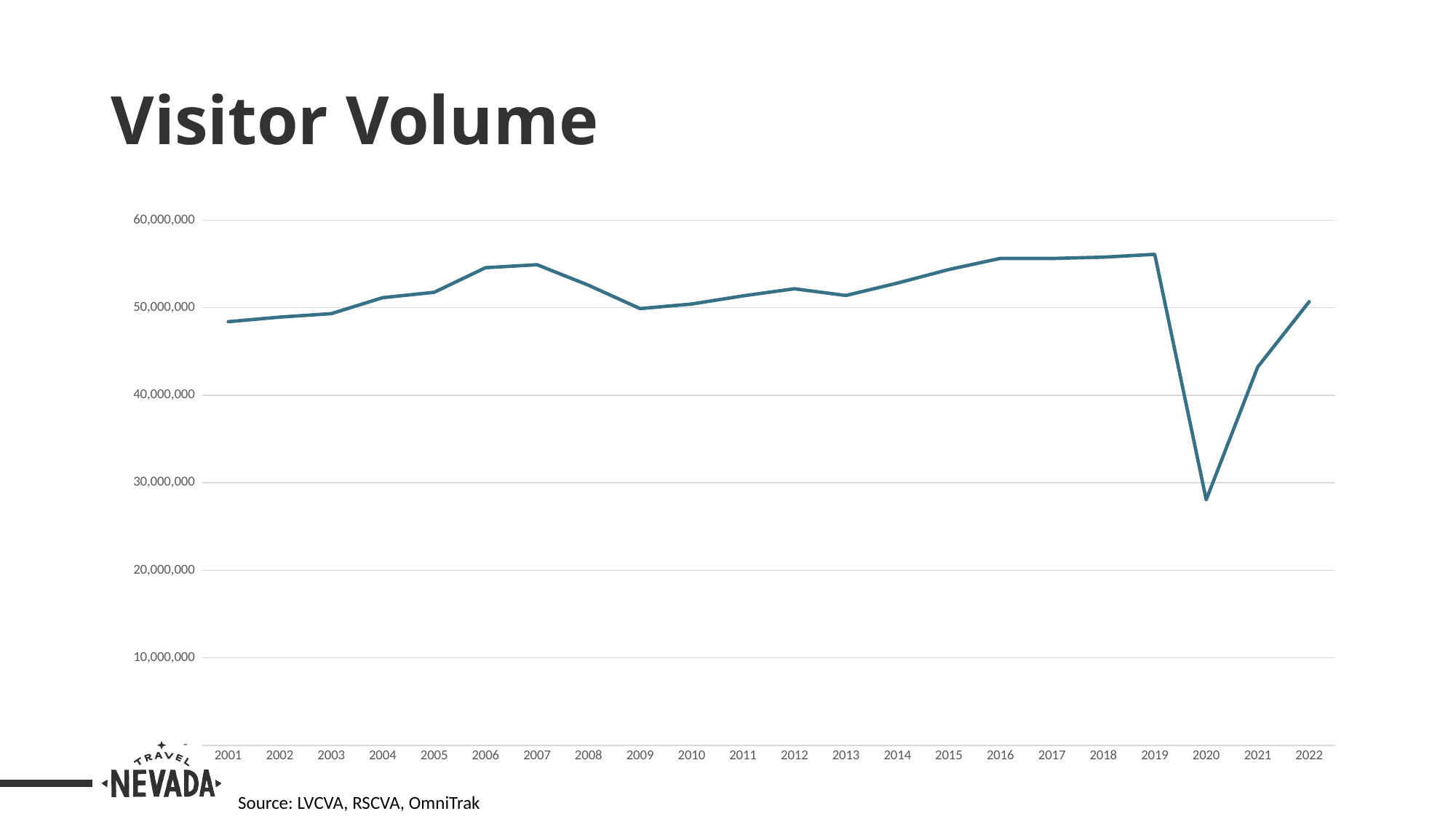
Is the visitor volume for 2001 greater or less than 50,000,000? less Which year has the larger visitor volume, 2007 or 2009? 2007 Is the visitor volume for 2020 greater or less than 30,000,000? less Is the visitor volume for 2021 greater or less than 40,000,000? greater Does visitor volume rise or fall from 2020 to 2022? rise Does visitor volume rise or fall from 2019 to 2020? fall What is the title of the slide? Visitor Volume What kind of chart is shown on the slide? line chart Which year has the larger visitor volume, 2020 or 2021? 2021 Which year has the lowest visitor volume? 2020 How many years are plotted along the x axis? 22